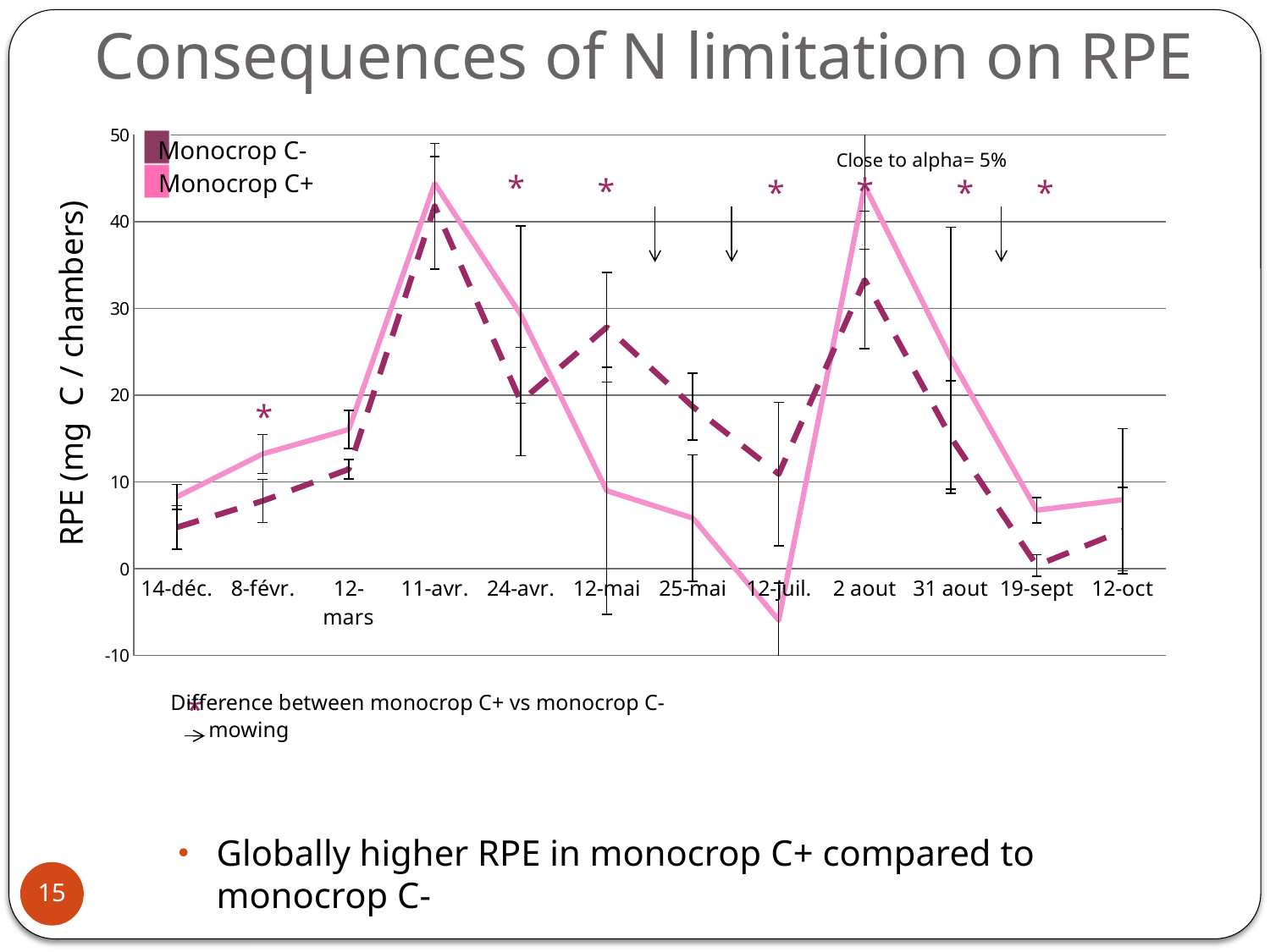
How many dates are shown along the x axis? 12 On which date does Monocrop C- reach its highest value? 11-avr. What kind of chart is shown on the slide? Line chart What is the y-axis title of the chart? RPE (mg C / chambers) How many series does the legend list? 2 Is the value for Monocrop C- on 12-mai greater or less than 20? greater Does the Monocrop C+ line rise or fall from 11-avr. to 12-juil.? Fall On which date does Monocrop C+ reach its lowest value? 12-juil. Is the value for Monocrop C+ on 11-avr. greater or less than 40? greater Which series is drawn with a dashed line? Monocrop C- On 12-mai, which series has the larger value, Monocrop C+ or Monocrop C-? Monocrop C- Is the value for Monocrop C+ on 12-juil. greater or less than 0? less